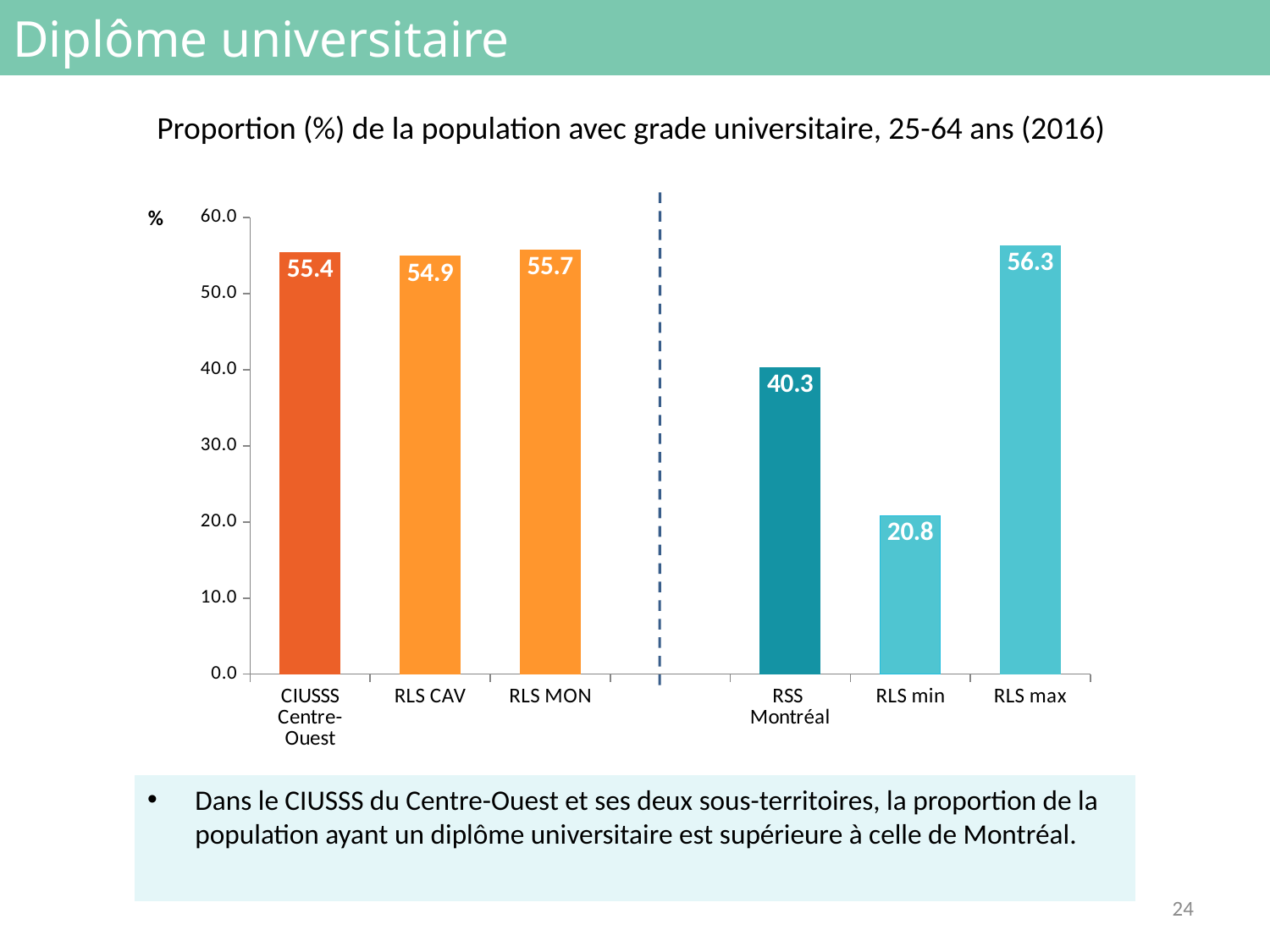
Which category has the highest value? RLS max What is the value for CIUSSS Centre-Ouest? 55.4 What kind of chart is this? bar chart What is the value for RLS CAV? 54.9 What is the value for RSS Montréal? 40.3 How many categories are shown on the x axis? 6 Which is larger, the value for RLS MON or the value for RSS Montréal? RLS MON What is the difference between the values for CIUSSS Centre-Ouest and RSS Montréal? 15.1 Which category has the lowest value? RLS min What is the title of the chart? Proportion (%) de la population avec grade universitaire, 25-64 ans (2016) What is the value for RLS min? 20.8 Is the value for RLS min greater or less than 30.0? less